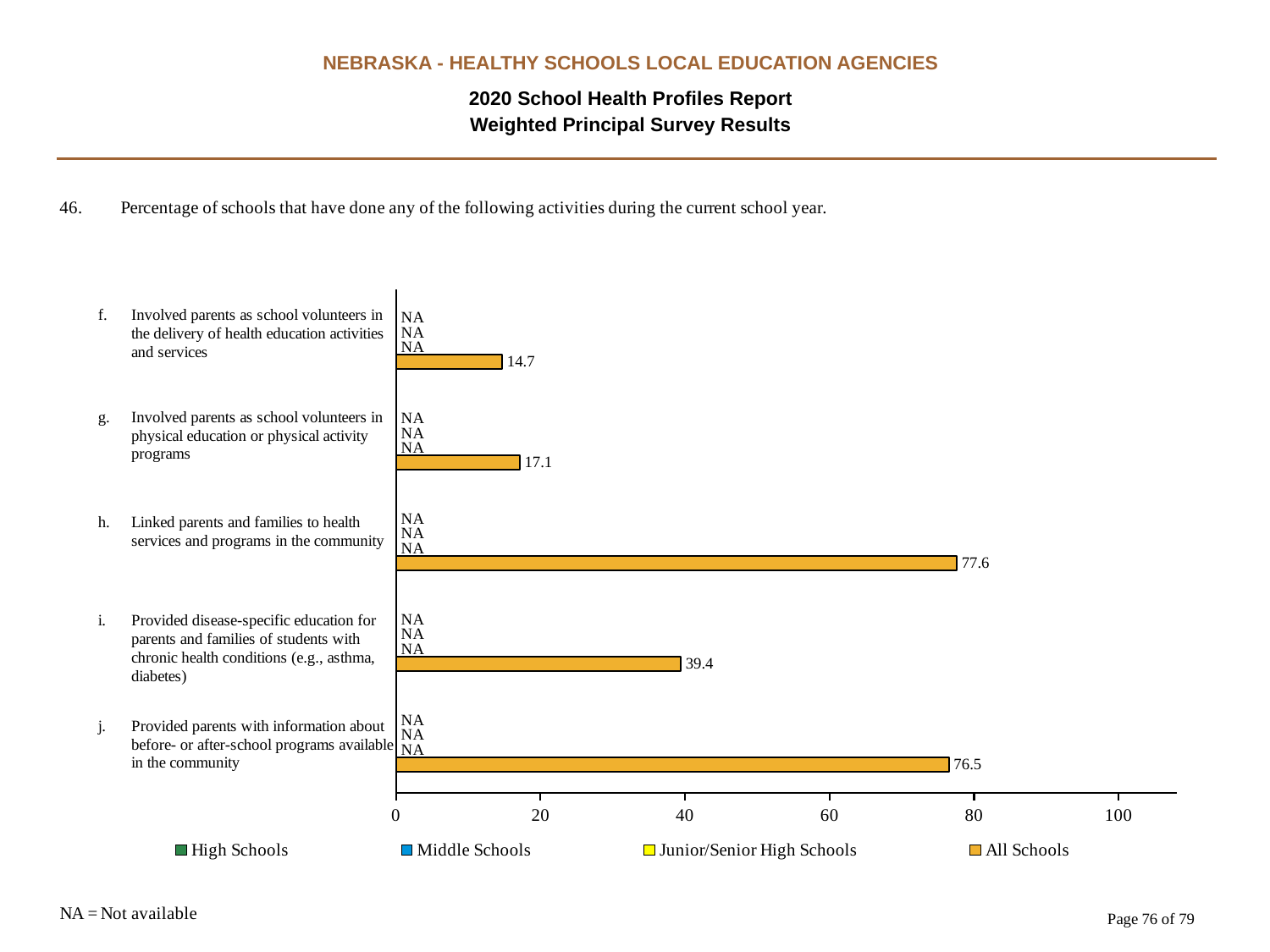
What kind of chart is shown on the slide? Bar chart How many activities (categories) are shown on the chart? 5 Which activity has the highest All Schools percentage? Linked parents and families to health services and programs in the community What is the All Schools value for 'Linked parents and families to health services and programs in the community'? 77.6 Which activity has the lowest All Schools percentage? Involved parents as school volunteers in the delivery of health education activities and services What is the All Schools value for 'Provided disease-specific education for parents and families of students with chronic health conditions'? 39.4 What is the All Schools value for 'Involved parents as school volunteers in physical education or physical activity programs'? 17.1 Is the All Schools value for 'Provided parents with information about before- or after-school programs available in the community' greater or less than 60? greater What is the difference between the All Schools values for item h (77.6) and item j (76.5)? 1.1 Which is larger for All Schools: item i (disease-specific education) or item g (volunteers in physical education)? Item i (disease-specific education) How many series does the legend list? 4 What value is shown for High Schools, Middle Schools, and Junior/Senior High Schools for every activity? NA